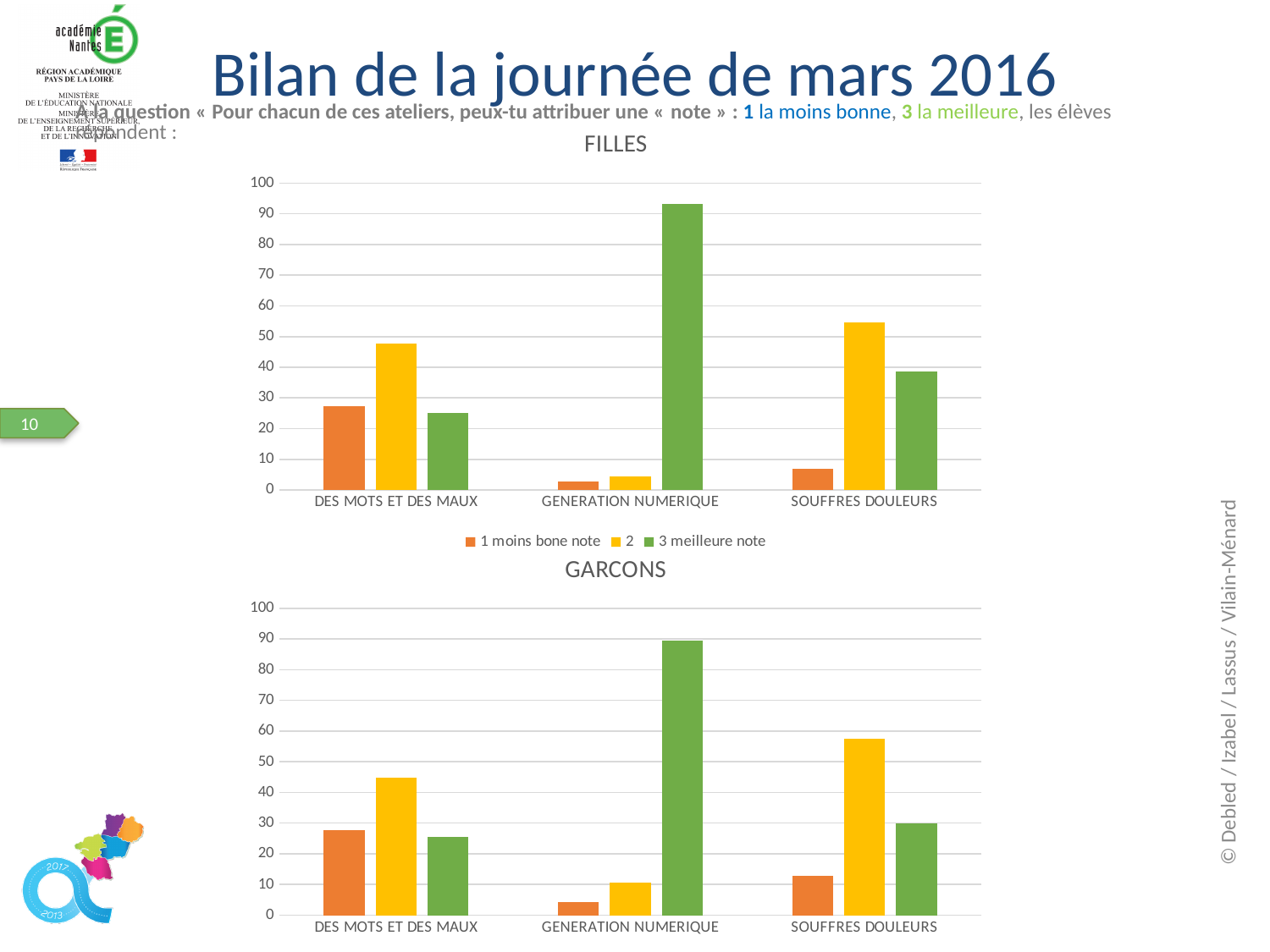
In the FILLES chart, is the value for '3 meilleure note' at GENERATION NUMERIQUE greater or less than 90? greater In the FILLES chart, which category has the highest value for the series '3 meilleure note'? GENERATION NUMERIQUE How many series does the legend list for the FILLES chart? 3 In the GARCONS chart, is the value for '2' at SOUFFRES DOULEURS greater or less than 50? greater In the GARCONS chart, which category has the lowest value for the series '1 moins bone note'? GENERATION NUMERIQUE In the GARCONS chart, which category has the highest value for the series '2'? SOUFFRES DOULEURS How many categories are shown on the x axis of the GARCONS chart? 3 In the GARCONS chart, which is larger at DES MOTS ET DES MAUX: the value for '2' or the value for '3 meilleure note'? 2 In the FILLES chart, is the value for '1 moins bone note' at SOUFFRES DOULEURS greater or less than 10? less What is the title of the lower chart on the slide? GARCONS In the FILLES chart, which is larger at SOUFFRES DOULEURS: the value for '2' or the value for '1 moins bone note'? 2 What kind of chart is the FILLES chart? bar chart